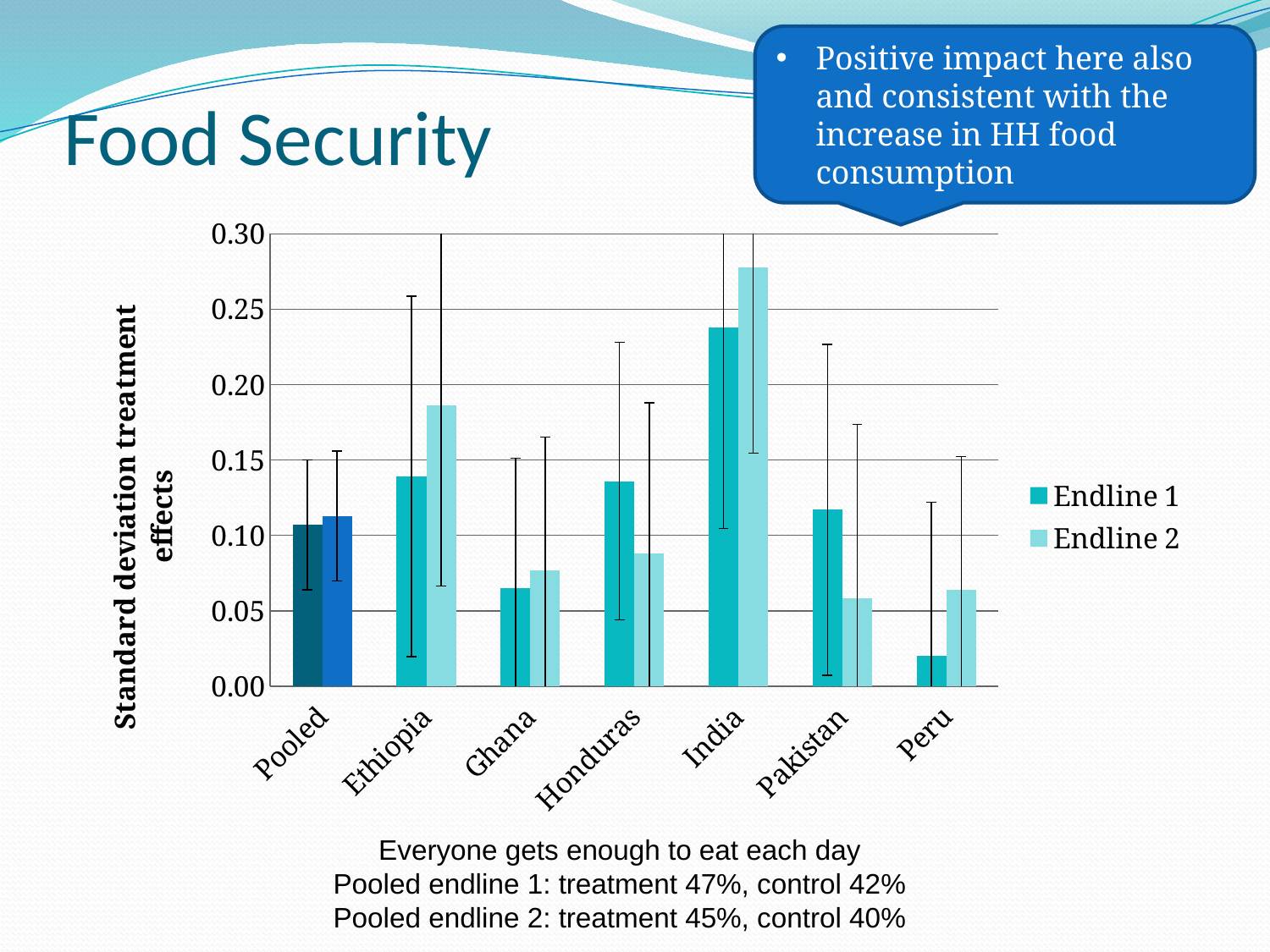
How many categories are shown on the x axis? 7 For Honduras, which is larger: the Endline 1 value or the Endline 2 value? Endline 1 For Peru, which is larger: the Endline 1 value or the Endline 2 value? Endline 2 Which category has the highest Endline 2 value? India How many series does the legend list? 2 Is the Endline 2 value for Ethiopia greater or less than 0.15? greater Is the Endline 2 value for India greater or less than 0.25? greater Is the Endline 1 value for Peru greater or less than 0.05? less Which category has the lowest Endline 1 value? Peru What kind of chart is shown on the slide? bar chart What is the title of the y axis? Standard deviation treatment effects Which category has the highest Endline 1 value? India